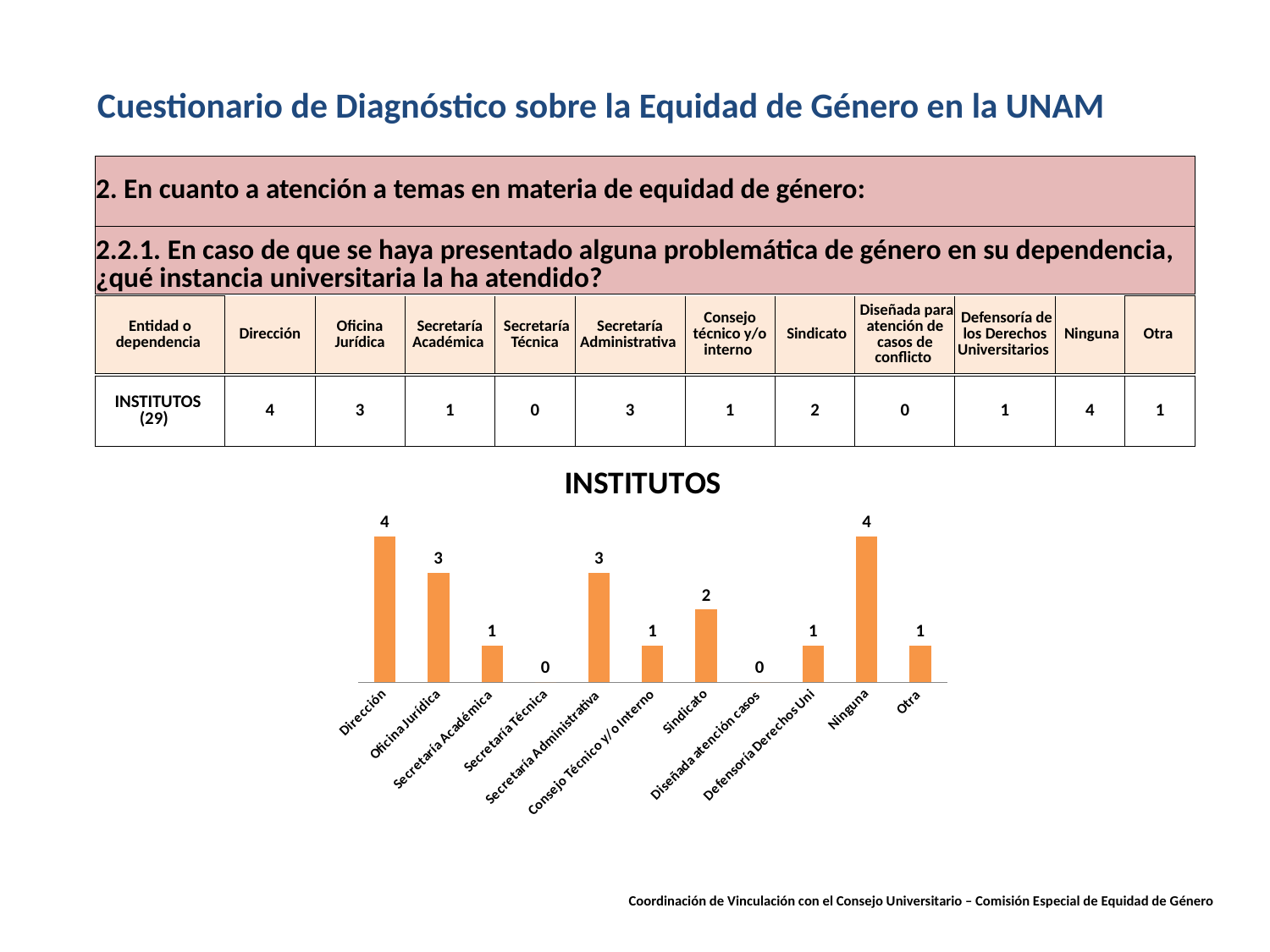
What is the difference between the values for Dirección and Sindicato in the INSTITUTOS chart? 2 What is the difference between the values for Oficina Jurídica and Secretaría Académica in the INSTITUTOS chart? 2 What kind of chart is the INSTITUTOS chart? Bar chart What is the value for Dirección in the INSTITUTOS chart? 4 What is the value for Ninguna in the INSTITUTOS chart? 4 How many categories are shown on the x axis of the INSTITUTOS chart? 11 What is the title of the chart on the slide? INSTITUTOS What is the value for Oficina Jurídica in the INSTITUTOS chart? 3 Which is larger in the INSTITUTOS chart, Secretaría Administrativa or Consejo Técnico y/o Interno? Secretaría Administrativa What is the value for Secretaría Técnica in the INSTITUTOS chart? 0 Which is larger in the INSTITUTOS chart, Sindicato or Otra? Sindicato What is the value for Sindicato in the INSTITUTOS chart? 2